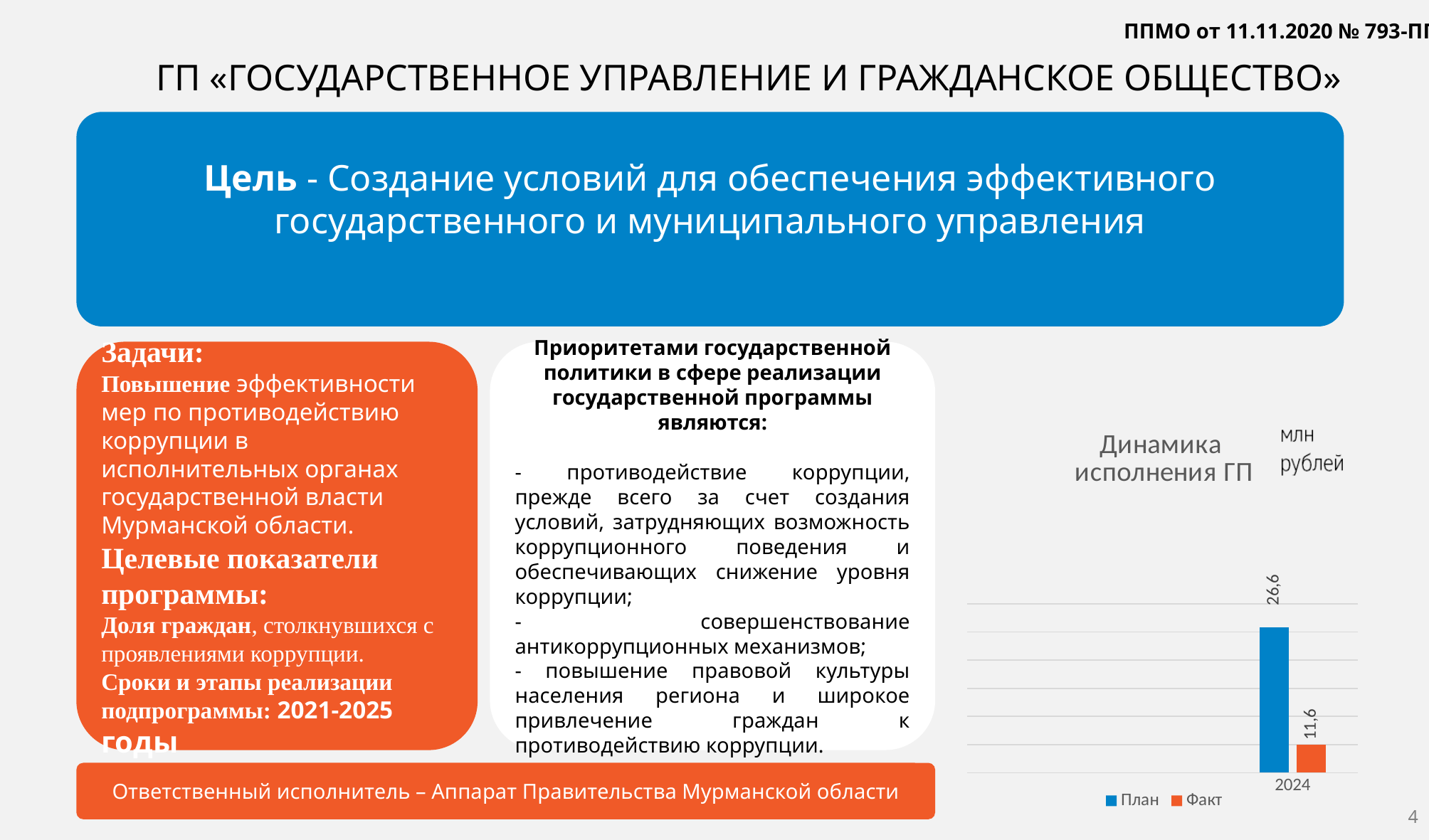
Which series has the higher value for 2024, План or Факт? План What is the value of the План series for 2024 in the chart? 26,6 What is the title of the chart? Динамика исполнения ГП How many categories are shown on the x axis of the chart? 1 What is the value of the Факт series for 2024 in the chart? 11,6 How many series does the chart legend list? 2 Which year is shown on the x axis of the chart? 2024 What unit is indicated for the values in the chart? млн рублей What is the difference between the План and Факт values for 2024? 15 What kind of chart is shown on the slide? bar chart Which series has the lowest value in the chart? Факт